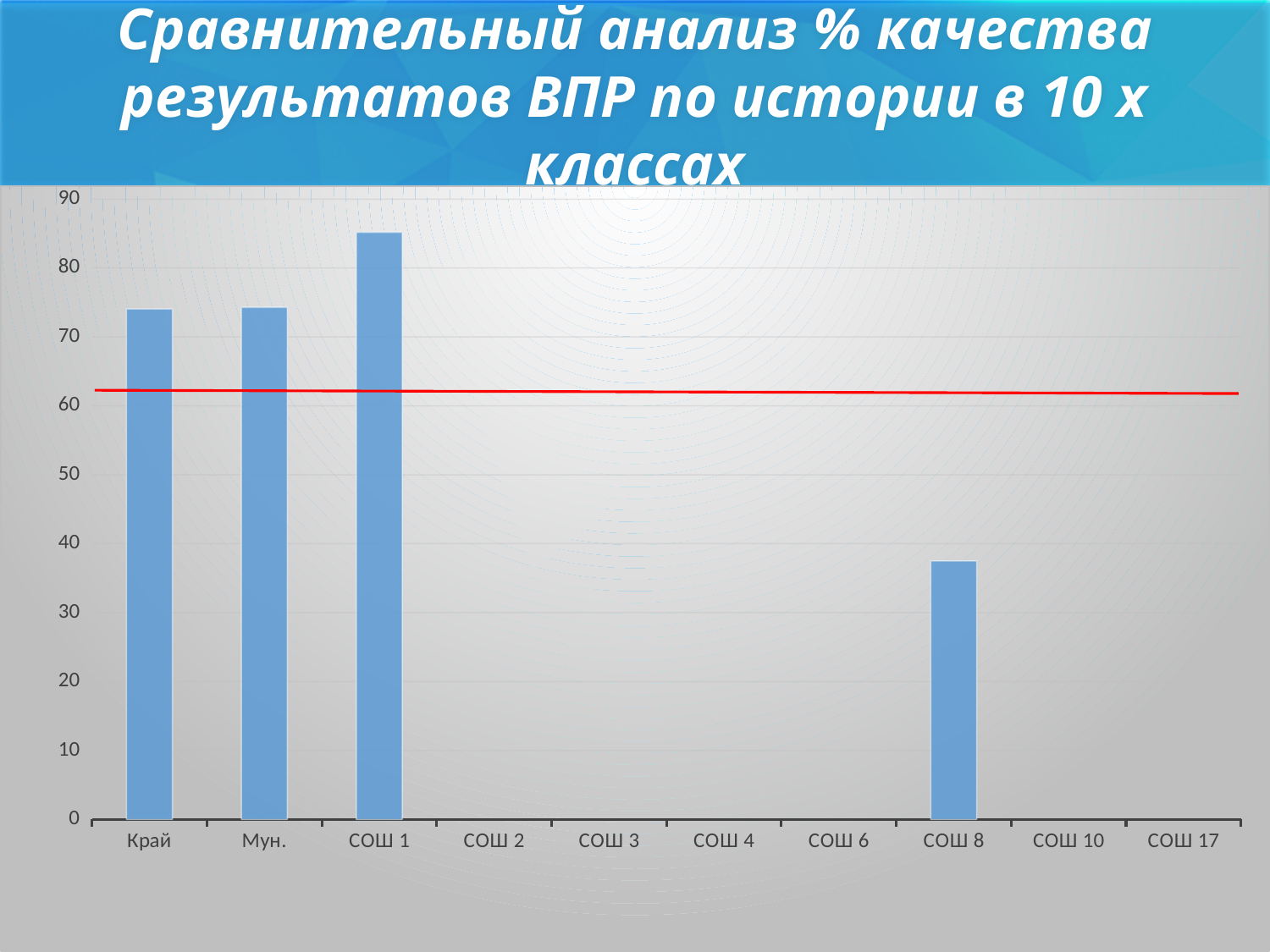
Which is larger, the value for СОШ 1 or the value for СОШ 8? СОШ 1 Which category has the highest bar in the chart? СОШ 1 What colour is the horizontal line drawn across the chart? red What is the title of the slide containing the chart? Сравнительный анализ % качества результатов ВПР по истории в 10 х классах Which is larger, the value for Край or the value for СОШ 8? Край Is the value for СОШ 1 greater or less than 80? greater Is the value for Мун. greater or less than 80? less How many categories are listed along the x axis of the chart? 10 Is the value for Край greater or less than 70? greater What kind of chart is shown on the slide? bar chart How many categories have a visible bar in the chart? 4